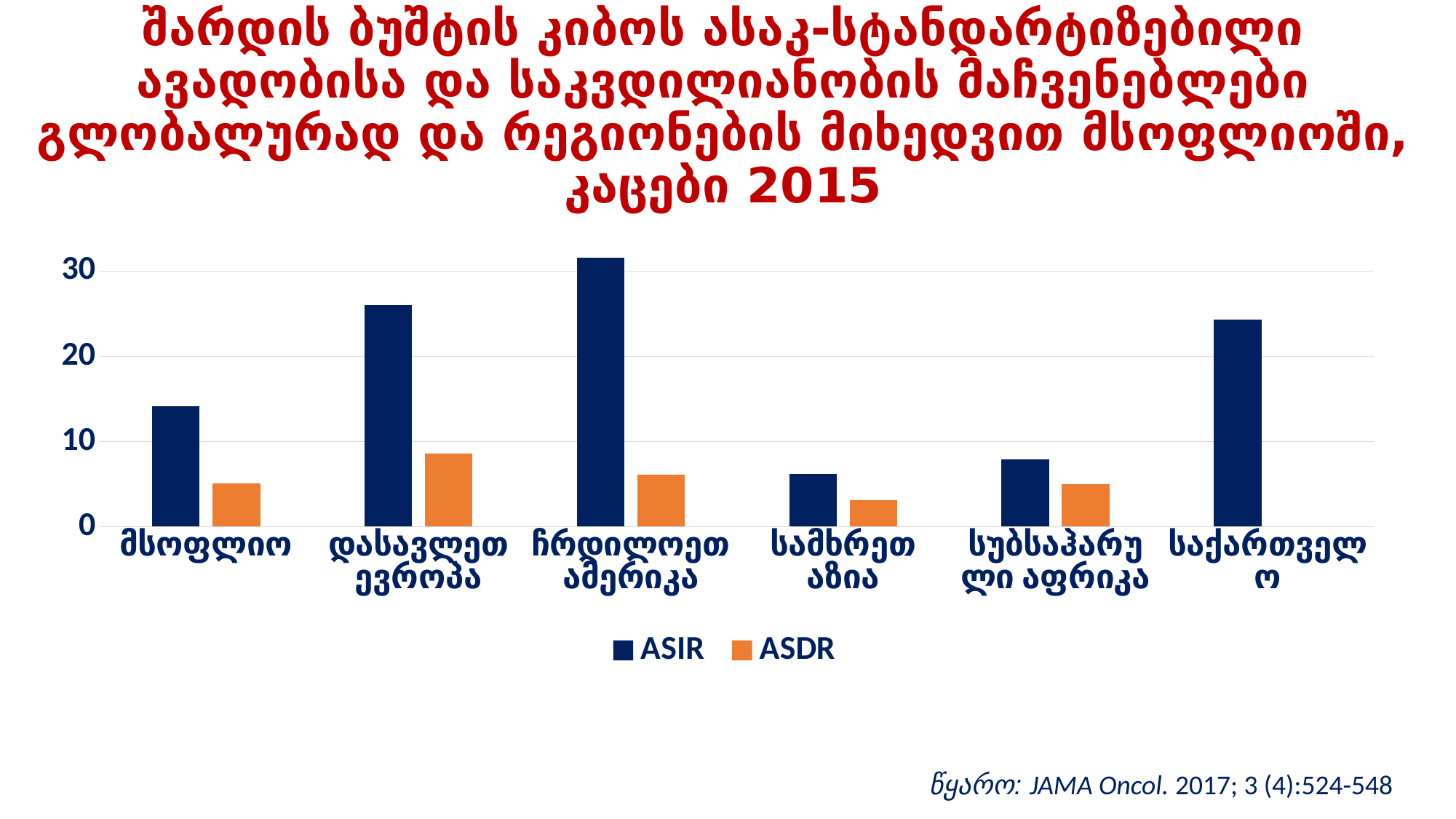
Which category has the lowest ASDR value among those with an ASDR bar? სამხრეთ აზია Which is larger, the ASIR value for დასავლეთ ევროპა or the ASIR value for საქართველო? დასავლეთ ევროპა Is the ASDR value for დასავლეთ ევროპა greater or less than 10? less How many series does the legend list? 2 Which category has the lowest ASIR value? სამხრეთ აზია How many categories are shown on the x axis? 6 Which category has the highest ASIR value? ჩრდილოეთ ამერიკა Is the ASIR value for ჩრდილოეთ ამერიკა greater or less than 30? greater Which series is shown in orange in the legend? ASDR Is the ASIR value for საქართველო greater or less than 20? greater What kind of chart is shown on the slide? bar chart Which category has the highest ASDR value? დასავლეთ ევროპა